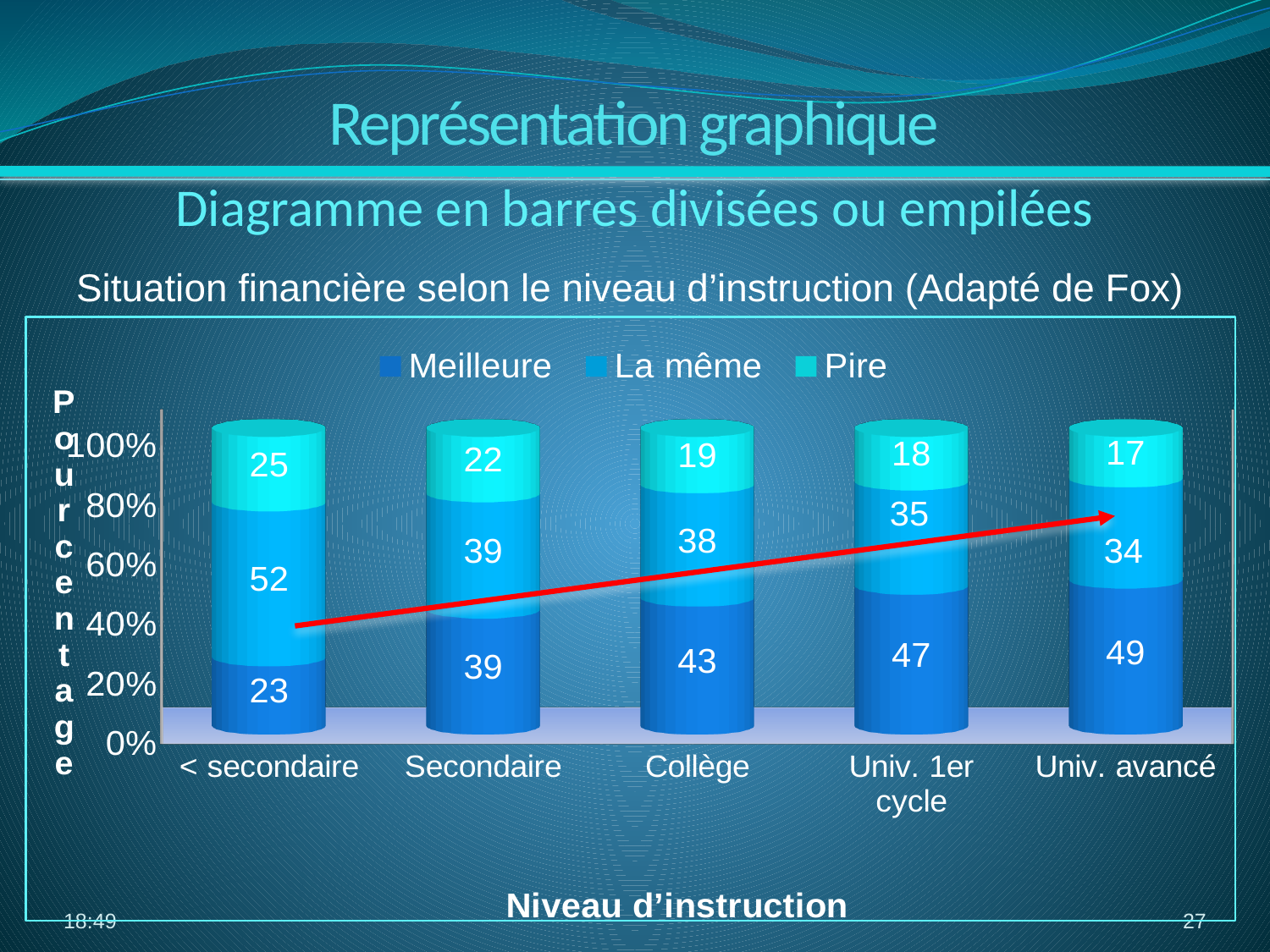
What is the difference between the La même values for < secondaire and Secondaire? 13 What is the value of the La même series for Univ. 1er cycle? 35 What is the value of the Meilleure series for < secondaire? 23 Which category has the lowest value for the Pire series? Univ. avancé Does the Meilleure series rise or fall from < secondaire to Univ. avancé? rise Which is larger: the Meilleure value for Collège or the Meilleure value for Univ. 1er cycle? Univ. 1er cycle What is the total of the three segments in the Secondaire bar? 100 How many education-level categories are shown on the x axis? 5 What kind of chart is shown on the slide? stacked bar chart How many series does the legend list? 3 What is the value of the Pire series for Collège? 19 Which category has the highest value for the Meilleure series? Univ. avancé